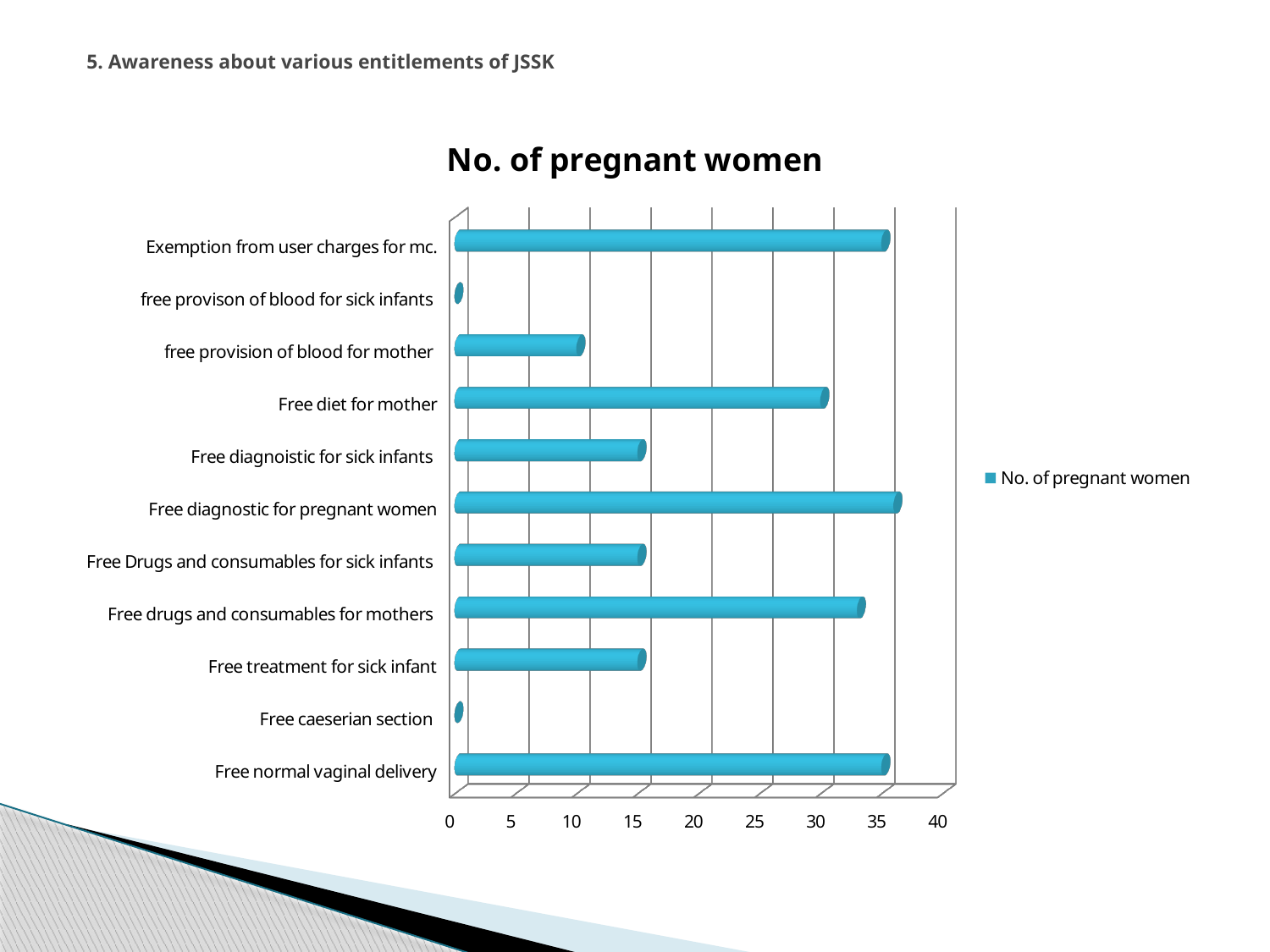
How many series does the legend list? 1 What kind of chart is shown on the slide? Bar chart Which is larger: the value for Free normal vaginal delivery or the value for Free caeserian section? Free normal vaginal delivery Is the value for free provision of blood for mother greater or less than 15? less Is the value for Free caeserian section greater or less than 5? less Is the value for Free drugs and consumables for mothers greater or less than 30? greater Which is larger: the value for Free drugs and consumables for mothers or the value for Free Drugs and consumables for sick infants? Free drugs and consumables for mothers Which is larger: the value for Free diet for mother or the value for free provision of blood for mother? Free diet for mother What is the title of the chart? No. of pregnant women How many categories are plotted in the chart? 11